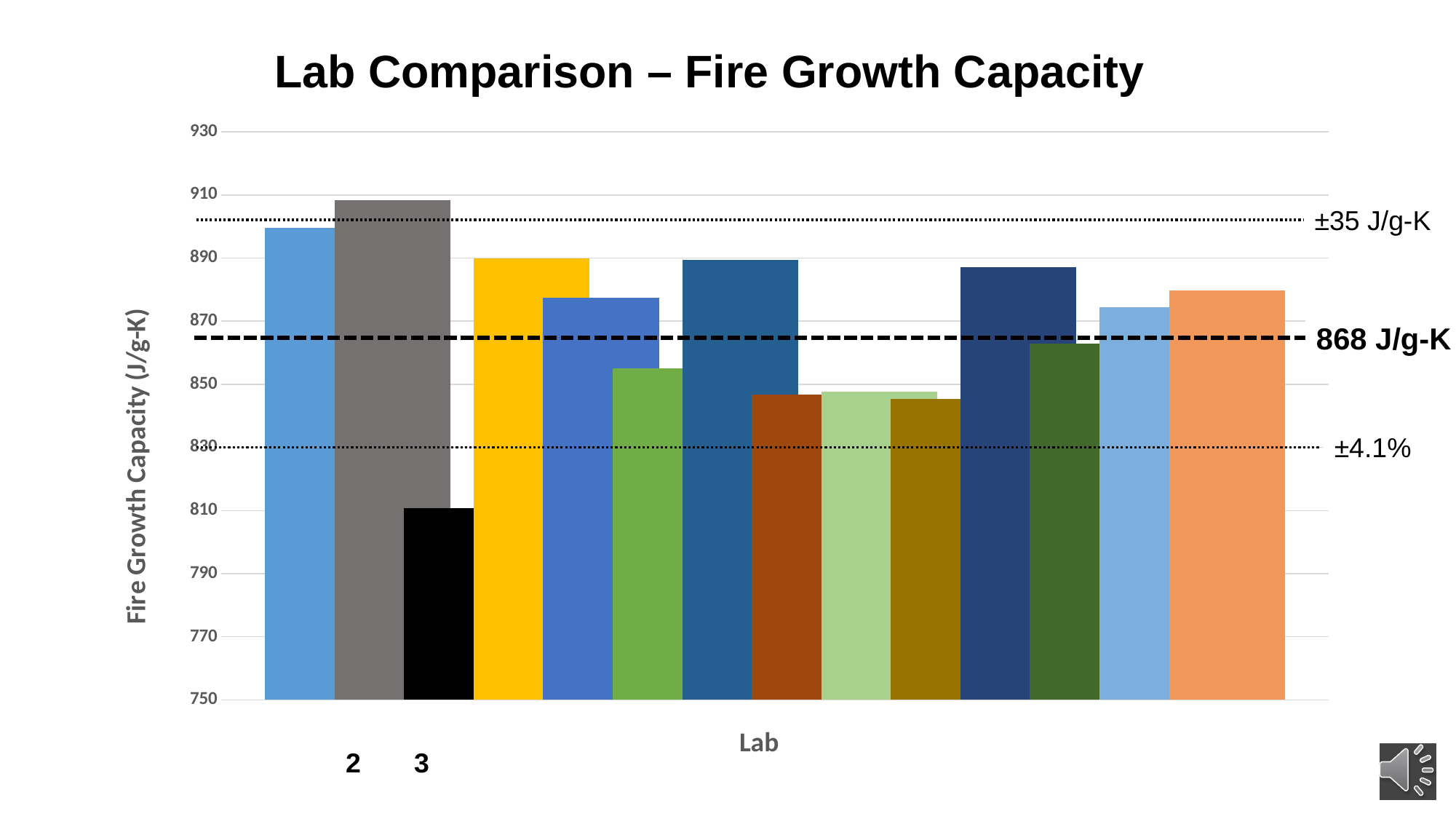
Is the value for Lab 3 greater or less than 830? less Which is larger, the value for Lab 2 or the value for Lab 3? Lab 2 How many bars are plotted in the chart? 14 What is the title of the chart? Lab Comparison – Fire Growth Capacity What value does the bold dashed horizontal line mark? 868 J/g-K What kind of chart is shown on the slide? bar chart Which lab has the lowest Fire Growth Capacity? Lab 3 Which lab has the highest Fire Growth Capacity? Lab 2 What is the label of the y axis? Fire Growth Capacity (J/g-K) Is the value for Lab 2 greater or less than 890? greater Is the value for Lab 2 greater or less than the 868 J/g-K dashed line? greater